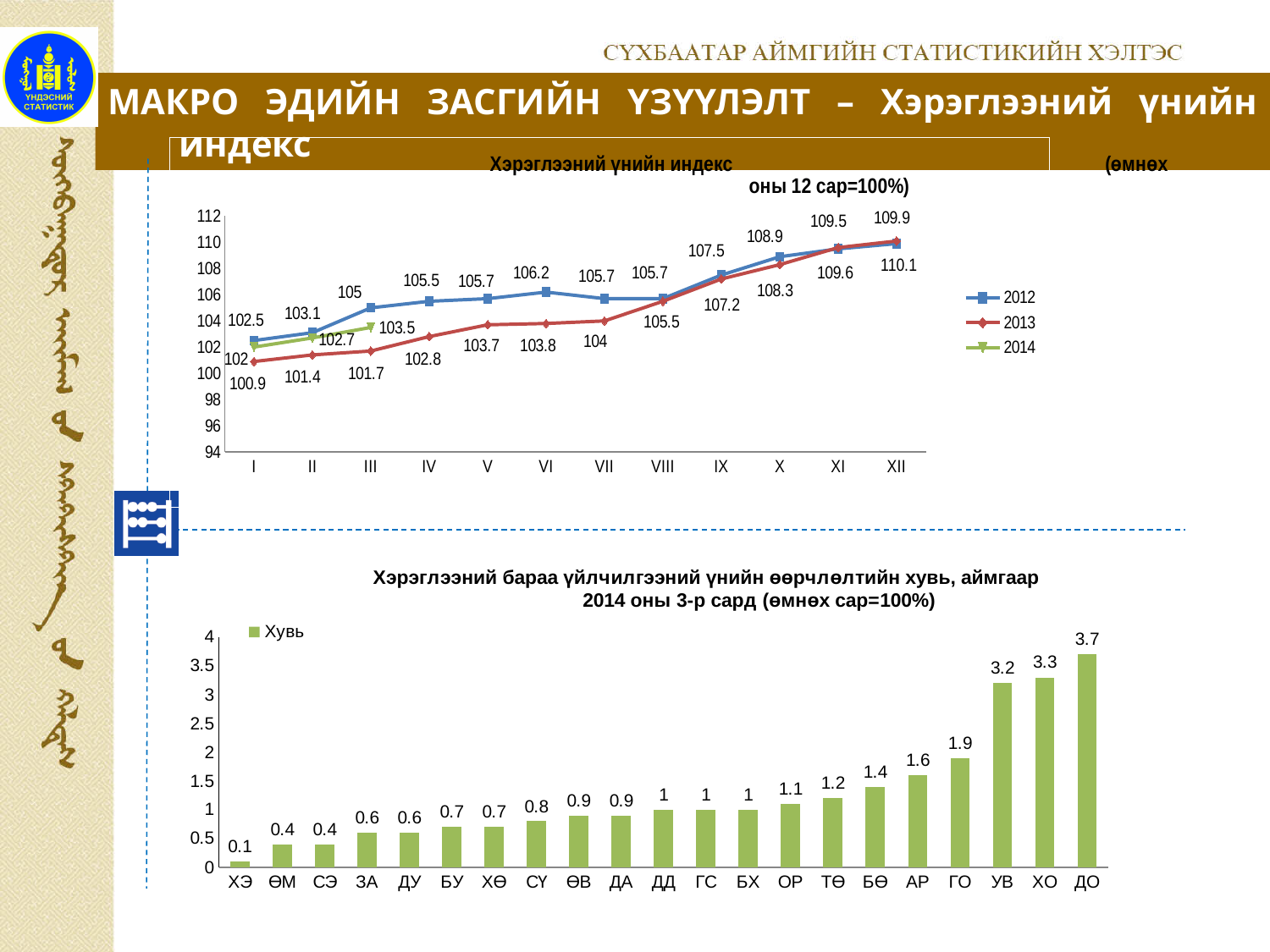
In the top chart (Хэрэглээний үнийн индекс), do the 2013 values rise or fall from month I to month XII? rise In the top chart (Хэрэглээний үнийн индекс), what is the value for the 2012 series in month VI? 106.2 In the bottom chart, which aimag has the highest value? ДО In the top chart (Хэрэглээний үнийн индекс), what is the value for the 2013 series in month XII? 110.1 In the top chart (Хэрэглээний үнийн индекс), what is the value for the 2014 series in month III? 103.5 In the top chart (Хэрэглээний үнийн индекс), which is larger in month X: the 2012 value or the 2013 value? 2012 In the bottom chart, what type of chart is used? bar chart In the top chart (Хэрэглээний үнийн индекс), what is the difference between the 2012 and 2013 values in month I? 1.6 In the bottom chart, which aimag has the lowest value? ХЭ In the bottom chart, what is the value for ГО? 1.9 In the top chart (Хэрэглээний үнийн индекс), how many series does the legend list? 3 In the bottom chart, how many aimags (categories) are shown? 21